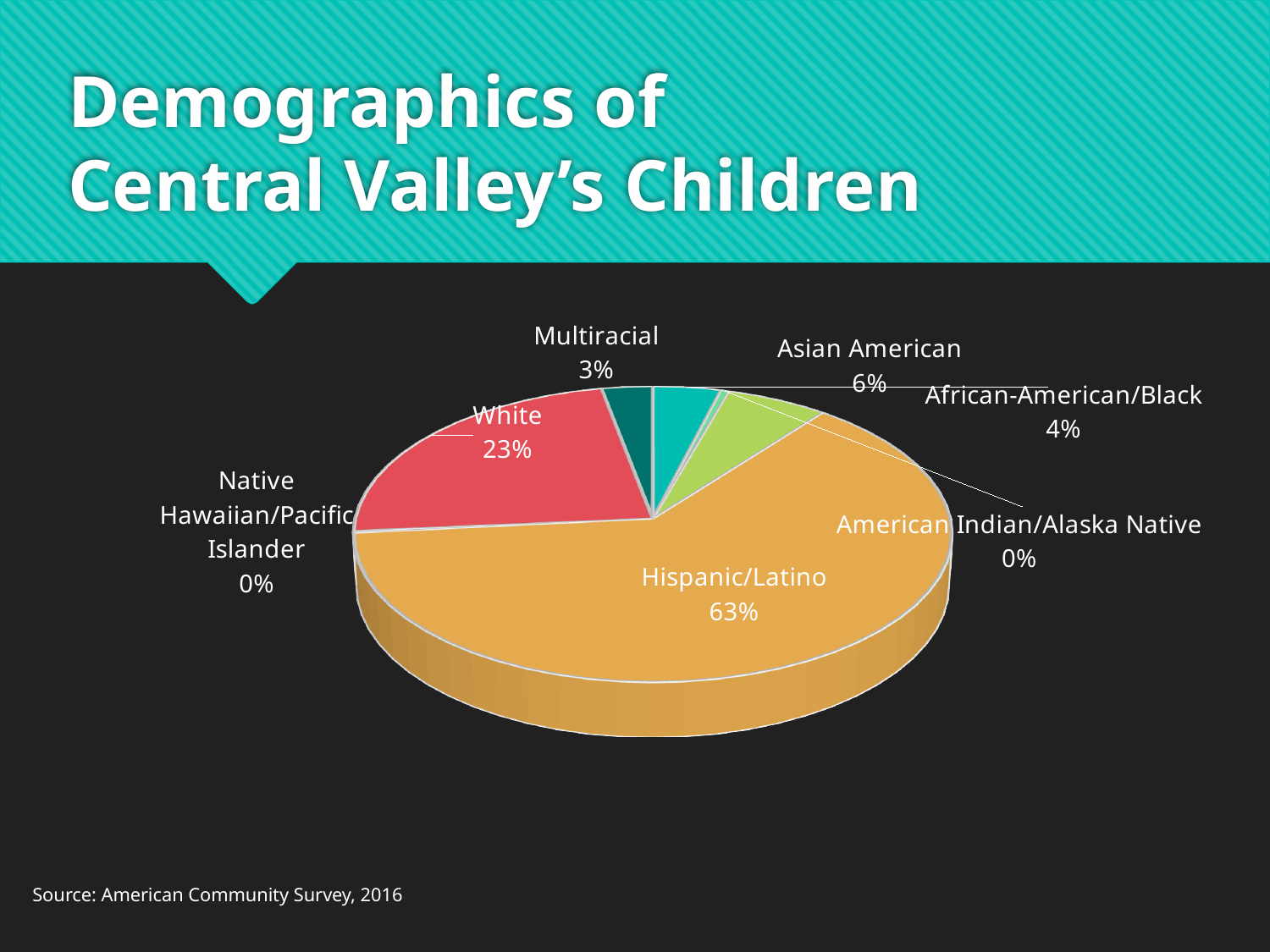
What percentage is shown for African-American/Black? 4% What source is cited for the chart data? American Community Survey, 2016 What percentage is shown for Asian American? 6% What percentage is shown for Native Hawaiian/Pacific Islander? 0% What is the difference in percentage points between the Hispanic/Latino and White slices? 40 What kind of chart is shown on the slide? Pie chart What percentage is shown for Multiracial? 3% How many categories are labelled on the pie chart? 7 Which category has the largest share of the pie? Hispanic/Latino What percentage does the White slice represent? 23% What share of Central Valley's children are Hispanic/Latino according to the pie chart? 63% Which is larger, the Asian American slice or the African-American/Black slice? Asian American